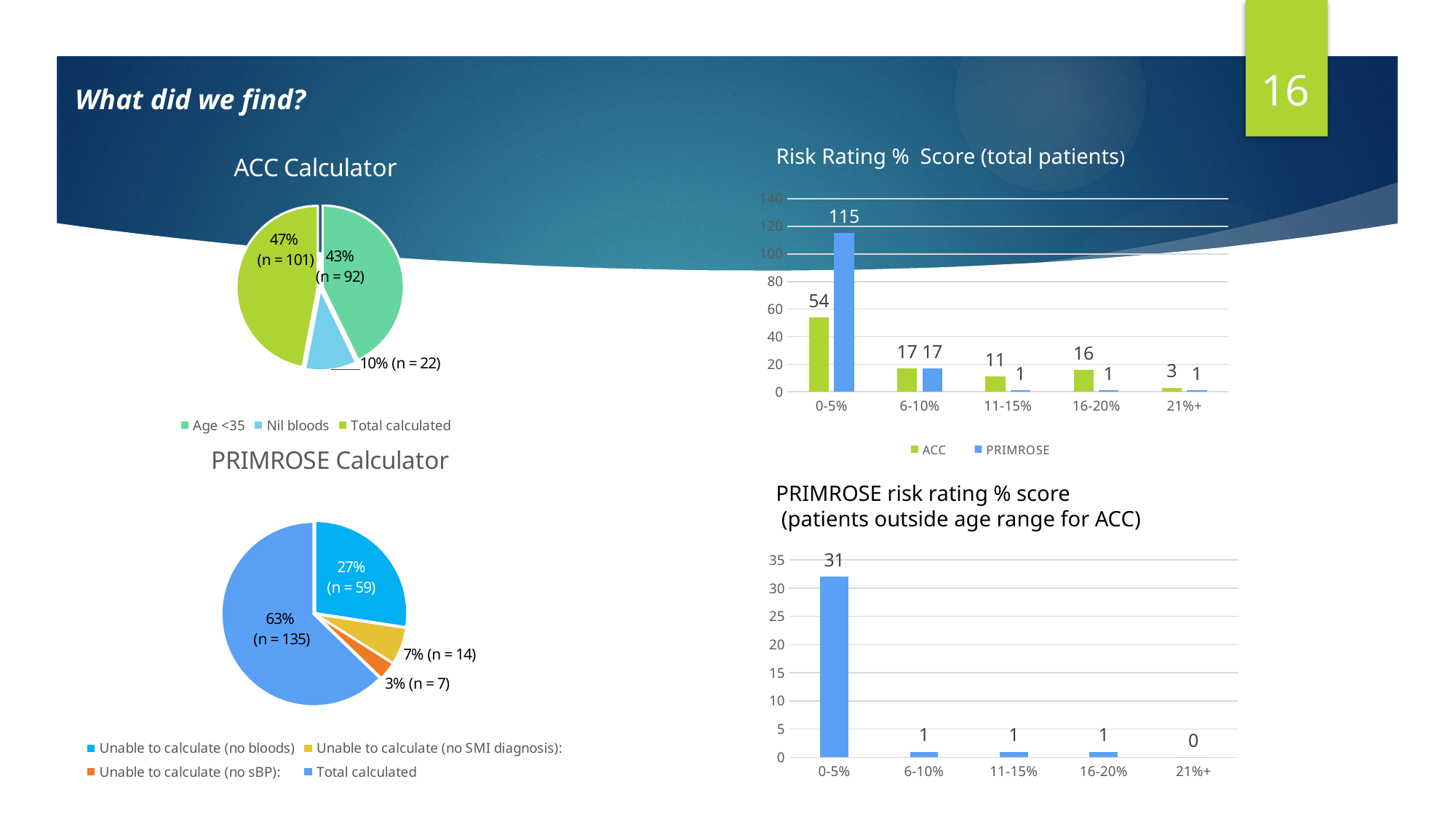
In the 'PRIMROSE risk rating % score (patients outside age range for ACC)' chart, what is the value for the 0-5% category? 31 In the 'Risk Rating % Score (total patients)' chart, what is the PRIMROSE value for the 0-5% category? 115 In the 'PRIMROSE risk rating % score (patients outside age range for ACC)' chart, how many categories are shown on the x axis? 5 In the 'Risk Rating % Score (total patients)' chart, which category has the lowest ACC value? 21%+ In the 'Risk Rating % Score (total patients)' chart, how many series does the legend list? 2 In the 'Risk Rating % Score (total patients)' chart, what is the difference between the PRIMROSE and ACC values for the 0-5% category? 61 In the 'ACC Calculator' pie chart, what is the n value for the 'Nil bloods' slice? n = 22 In the 'ACC Calculator' pie chart, what share does the 'Total calculated' slice have? 47% In the 'Risk Rating % Score (total patients)' chart, is the ACC value for 11-15% larger or smaller than the PRIMROSE value for 11-15%? larger What kind of chart is the 'PRIMROSE risk rating % score (patients outside age range for ACC)' chart? bar chart In the 'Risk Rating % Score (total patients)' chart, what is the ACC value for the 16-20% category? 16 In the 'PRIMROSE Calculator' pie chart, which slice is the largest? Total calculated